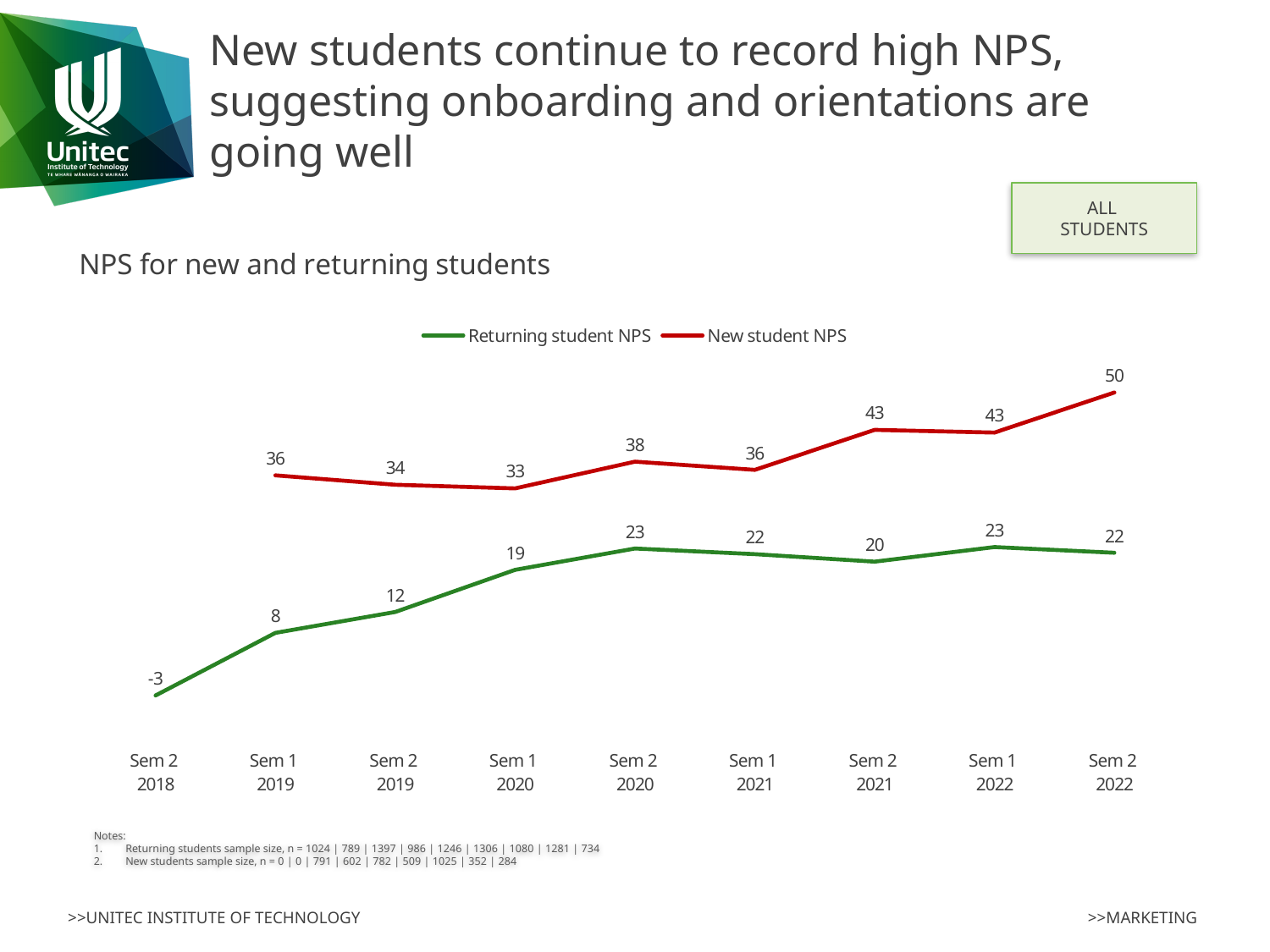
In which period is the Returning student NPS lowest? Sem 2 2018 What is the difference between the New student NPS and the Returning student NPS in Sem 2 2022? 28 What is the Returning student NPS for Sem 1 2020? 19 What is the New student NPS for Sem 1 2020? 33 What kind of chart is shown on the slide? Line chart What is the Returning student NPS for Sem 2 2018? -3 How many series does the legend list? 2 What colour is the line for New student NPS? Red How many periods are shown on the x axis? 9 What is the New student NPS for Sem 2 2022? 50 Which is larger in Sem 2 2021: the New student NPS or the Returning student NPS? New student NPS In which period is the New student NPS highest? Sem 2 2022